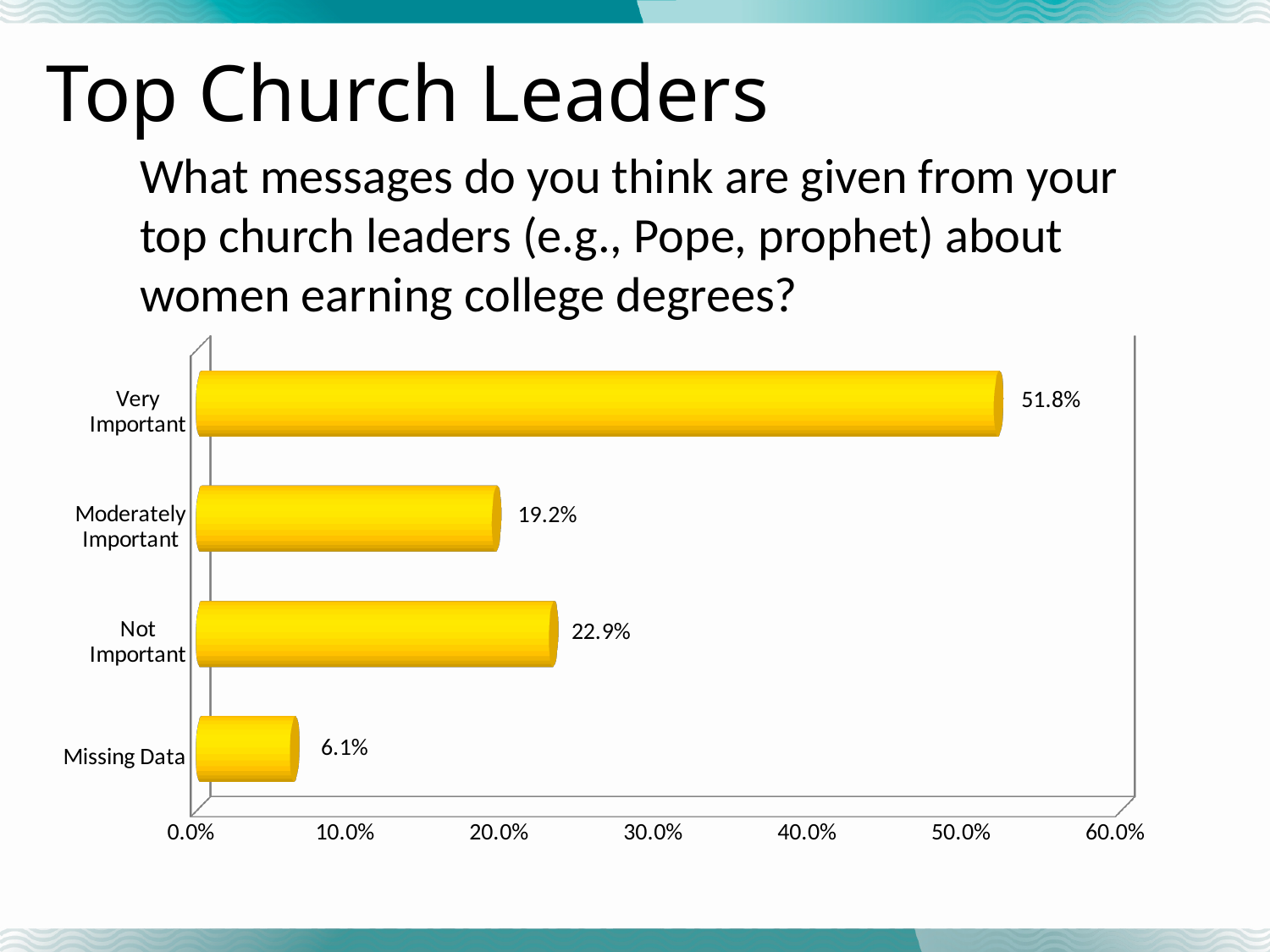
Which category has the lowest value? Missing Data Is the value for Very Important greater or less than 50.0%? greater Which category has the highest value? Very Important What is the value for Missing Data? 6.1% What is the value for Very Important? 51.8% What is the value for Not Important? 22.9% What is the value for Moderately Important? 19.2% Which is larger, the value for Not Important or the value for Moderately Important? Not Important What kind of chart is shown on the slide? bar chart How many categories are shown in the chart? 4 What colour are the bars in the chart? yellow What is the difference between the values for Very Important and Not Important? 28.9%